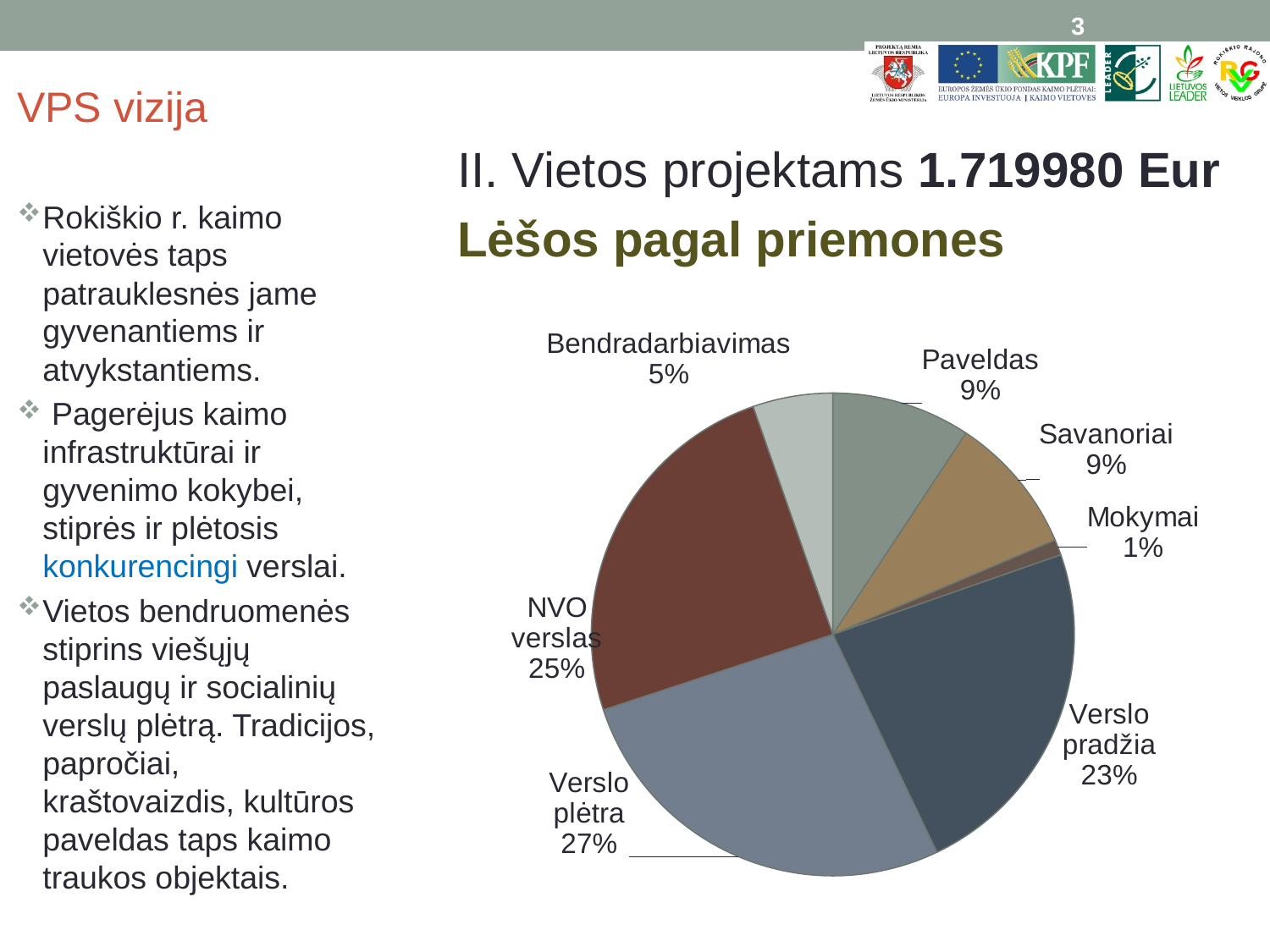
Which category has the largest slice of the pie? Verslo plėtra What is the value shown for NVO verslas? 25% What share of the pie does Verslo plėtra have? 27% What is the title of the chart? Lėšos pagal priemones Which category has the smallest slice of the pie? Mokymai What is the difference between the shares of Verslo plėtra and Verslo pradžia? 4% What is the value shown for Verslo pradžia? 23% What is the value shown for Bendradarbiavimas? 5% What is the value shown for Mokymai? 1% Which is larger, the share for NVO verslas or the share for Verslo pradžia? NVO verslas How many slices does the pie chart have? 7 What kind of chart is shown on the slide? pie chart